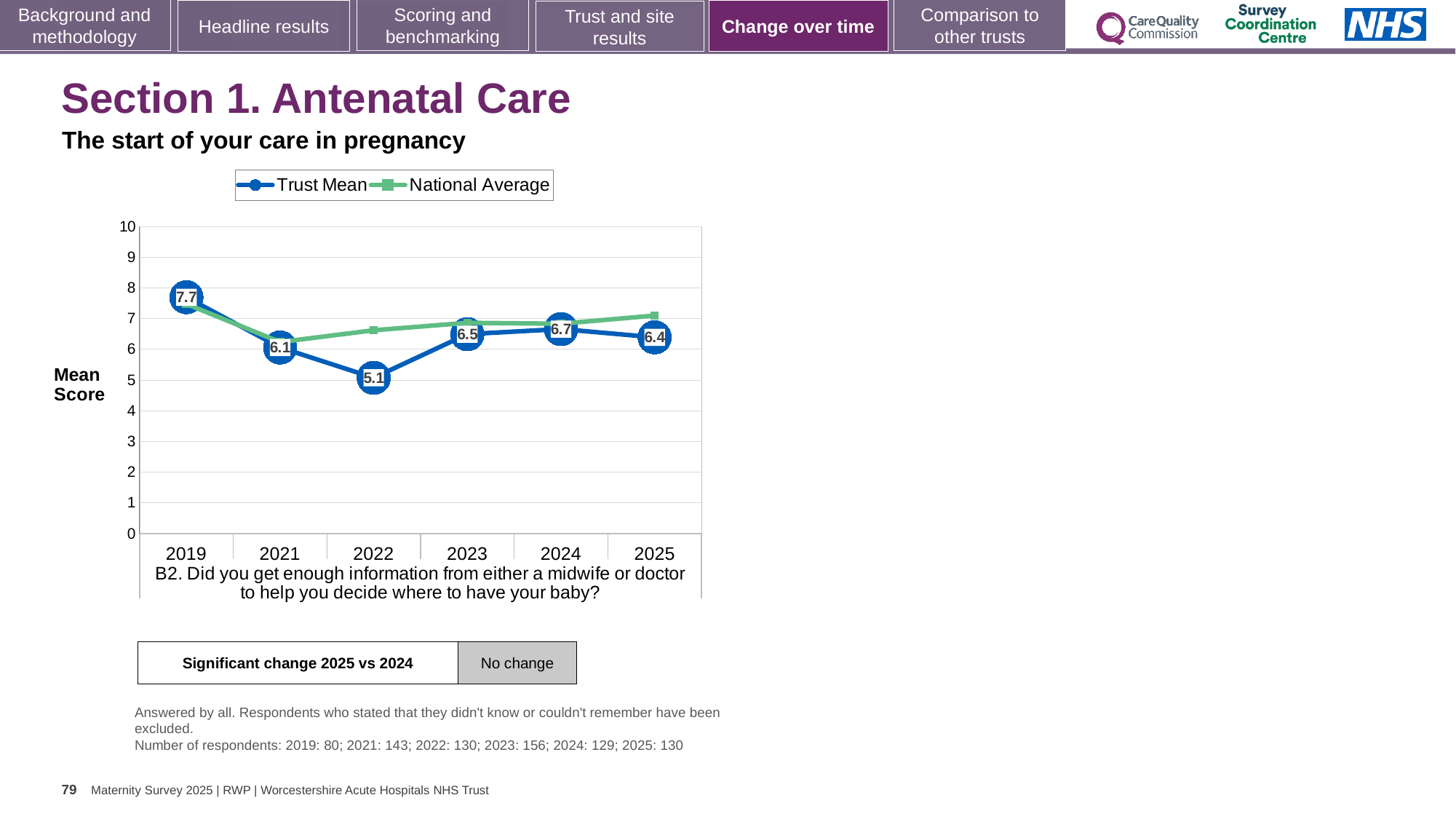
How many series does the legend list? 2 What kind of chart is shown on the slide? Line chart What is the Trust Mean for 2025? 6.4 What is the difference between the Trust Mean in 2019 and in 2022? 2.6 Which is larger, the Trust Mean in 2024 or in 2025? 2024 What is the Trust Mean for 2019? 7.7 Is the National Average for 2022 greater or less than 6? greater How many years are shown on the x axis? 6 What is the Trust Mean for 2022? 5.1 In which year is the Trust Mean lowest? 2022 Does the Trust Mean rise or fall from 2022 to 2023? Rise In which year is the Trust Mean highest? 2019